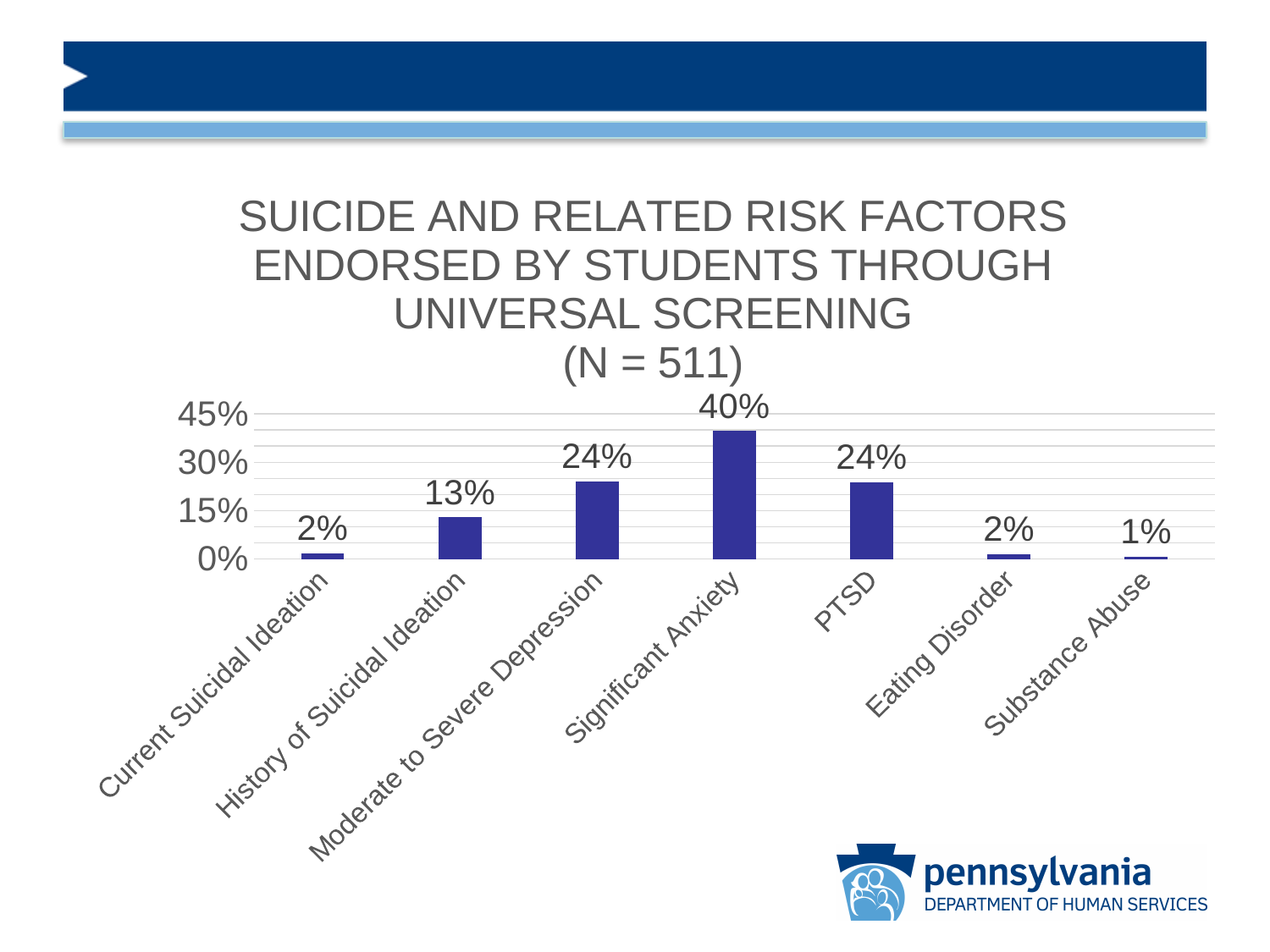
What is the value for History of Suicidal Ideation? 13% What is the difference between History of Suicidal Ideation and Current Suicidal Ideation? 11% What is the difference between the values for Significant Anxiety and PTSD? 16% What kind of chart is shown on the slide? Bar chart What sample size (N) is given in the chart title? 511 What percentage of students endorsed Significant Anxiety? 40% Which risk factor has the lowest percentage? Substance Abuse What percentage is shown for Substance Abuse? 1% Which is larger, the value for Moderate to Severe Depression or the value for History of Suicidal Ideation? Moderate to Severe Depression How many risk factor categories are shown on the chart? 7 Is the value for Significant Anxiety greater or less than 30%? greater Which risk factor has the highest percentage? Significant Anxiety